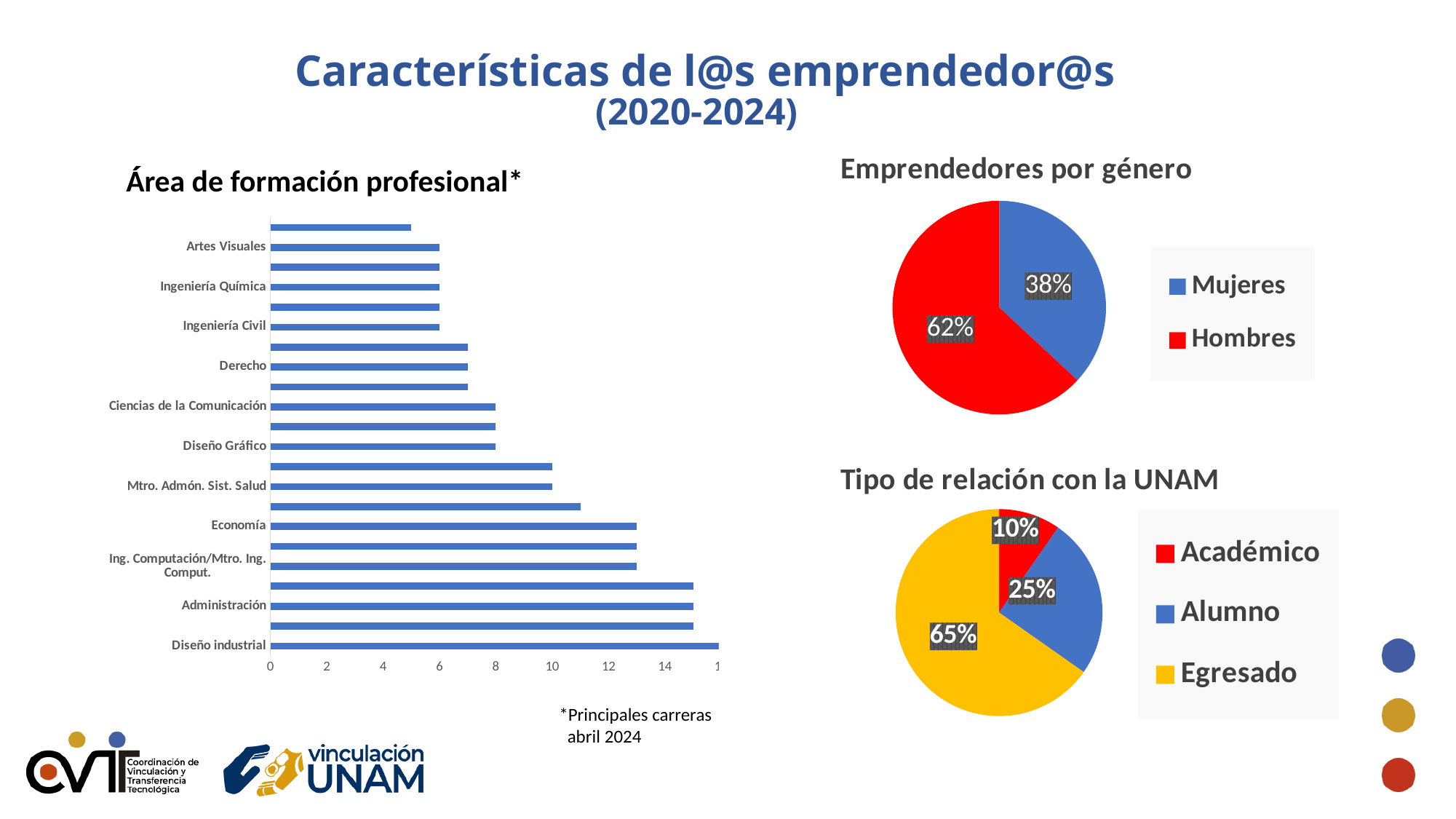
How many series does the legend of the 'Tipo de relación con la UNAM' chart list? 3 In the 'Emprendedores por género' pie chart, what percentage is Hombres? 62% In the 'Tipo de relación con la UNAM' pie chart, what share does Alumno have? 25% In the 'Emprendedores por género' pie chart, by how many percentage points does Hombres exceed Mujeres? 24 percentage points In the 'Área de formación profesional*' chart, which labeled category has the longest bar? Diseño industrial In the 'Tipo de relación con la UNAM' pie chart, which category has the smallest share? Académico In the 'Área de formación profesional*' chart, is the value for Artes Visuales greater or less than 8? less What kind of chart is 'Área de formación profesional*'? Bar chart In the 'Emprendedores por género' pie chart, what percentage is Mujeres? 38% In the 'Área de formación profesional*' chart, which is larger, the value for Administración or the value for Derecho? Administración In the 'Área de formación profesional*' chart, is the value for Diseño industrial greater or less than 14? greater In the 'Tipo de relación con la UNAM' pie chart, which category has the largest share? Egresado